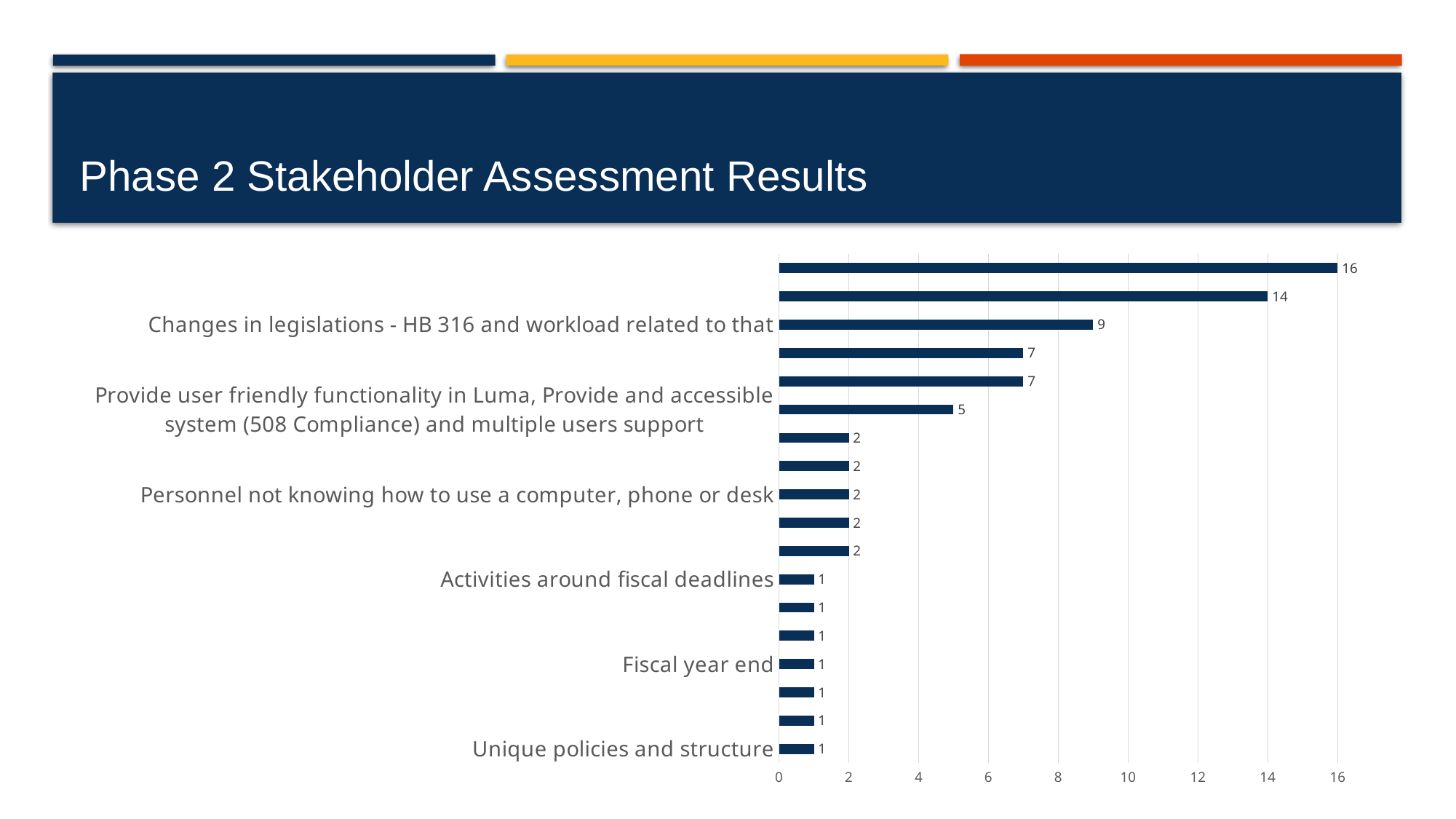
What is the value for "Changes in legislations - HB 316 and workload related to that"? 9 What is the value for "Provide user friendly functionality in Luma, Provide and accessible system (508 Compliance) and multiple users support"? 5 How many bars are plotted in the chart? 18 What is the value for "Unique policies and structure"? 1 What is the value for "Personnel not knowing how to use a computer, phone or desk"? 2 What is the difference between the value for "Changes in legislations - HB 316 and workload related to that" and the value for "Personnel not knowing how to use a computer, phone or desk"? 7 Which has a larger value: "Changes in legislations - HB 316 and workload related to that" or "Provide user friendly functionality in Luma, Provide and accessible system (508 Compliance) and multiple users support"? Changes in legislations - HB 316 and workload related to that Is the value for "Changes in legislations - HB 316 and workload related to that" greater or less than 8? greater What kind of chart is shown on the slide? Bar chart What is the value for "Fiscal year end"? 1 What is the value for "Activities around fiscal deadlines"? 1 What is the largest value shown on any bar in the chart? 16